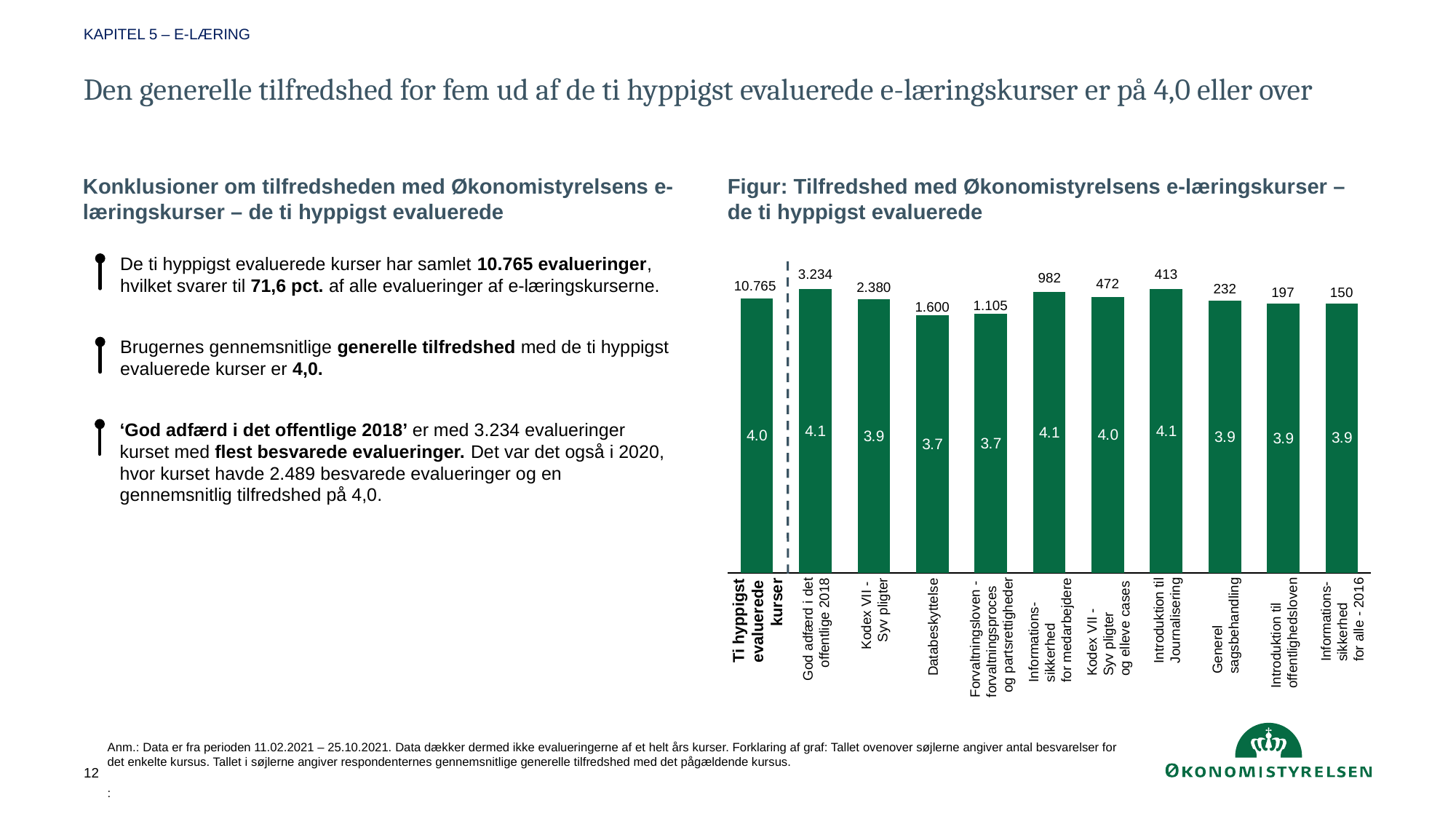
How many bars are plotted in the chart, including the 'Ti hyppigst evaluerede kurser' bar? 11 What satisfaction value is shown inside the bar for 'Kodex VII - Syv pligter og elleve cases'? 4.0 What is the difference in satisfaction between 'Introduktion til Journalisering' and 'Forvaltningsloven - forvaltningsproces og partsrettigheder'? 0.4 Which individual course has the highest number of evaluations shown above its bar? God adfærd i det offentlige 2018 What is the difference in number of evaluations between 'God adfærd i det offentlige 2018' and 'Kodex VII - Syv pligter'? 854 Which has more evaluations: 'Informationssikkerhed for medarbejdere' or 'Kodex VII - Syv pligter og elleve cases'? Informationssikkerhed for medarbejdere What is the total number of evaluations shown above the 'Ti hyppigst evaluerede kurser' bar? 10.765 What is the number of evaluations shown above the bar for 'Introduktion til Journalisering'? 413 Which individual course has the lowest number of evaluations shown above its bar? Informationssikkerhed for alle - 2016 What is the average general satisfaction shown inside the bar for 'Databeskyttelse'? 3.7 How many evaluations (the number above the bar) does 'God adfærd i det offentlige 2018' have? 3.234 What kind of chart is shown in the figure 'Tilfredshed med Økonomistyrelsens e-læringskurser – de ti hyppigst evaluerede'? Bar chart